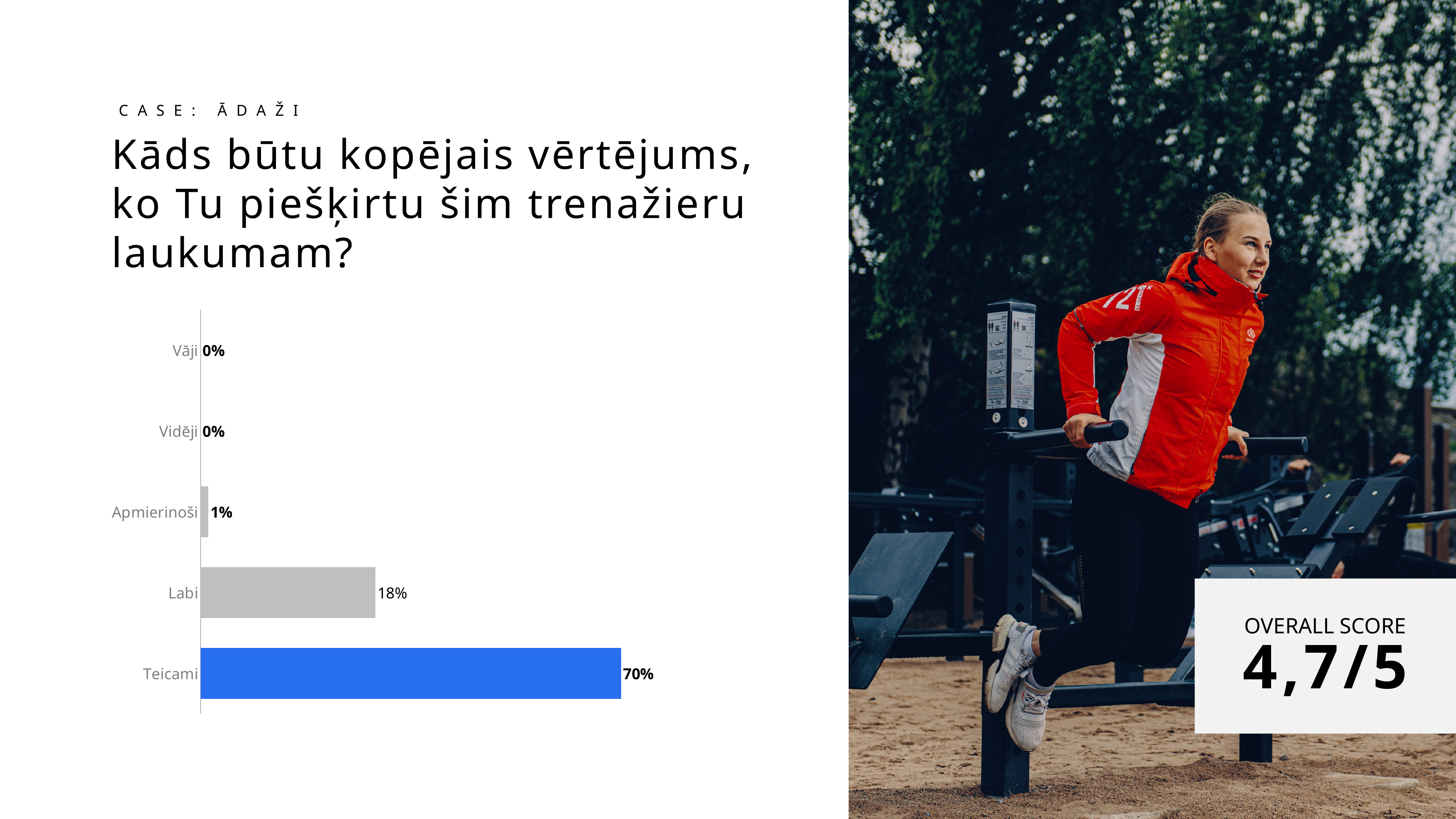
What colour is the bar for Teicami? Blue How many categories are shown in the chart? 5 Which category has the highest value? Teicami What overall score is shown on the slide? 4,7/5 Which is larger, the value for Labi or the value for Apmierinoši? Labi What is the value for Vāji? 0% What kind of chart is shown on the slide? Bar chart What is the difference between the values for Teicami and Labi? 52% What is the value for Teicami? 70% What is the difference between the values for Labi and Apmierinoši? 17% What is the value for Apmierinoši? 1% What is the value for Labi? 18%